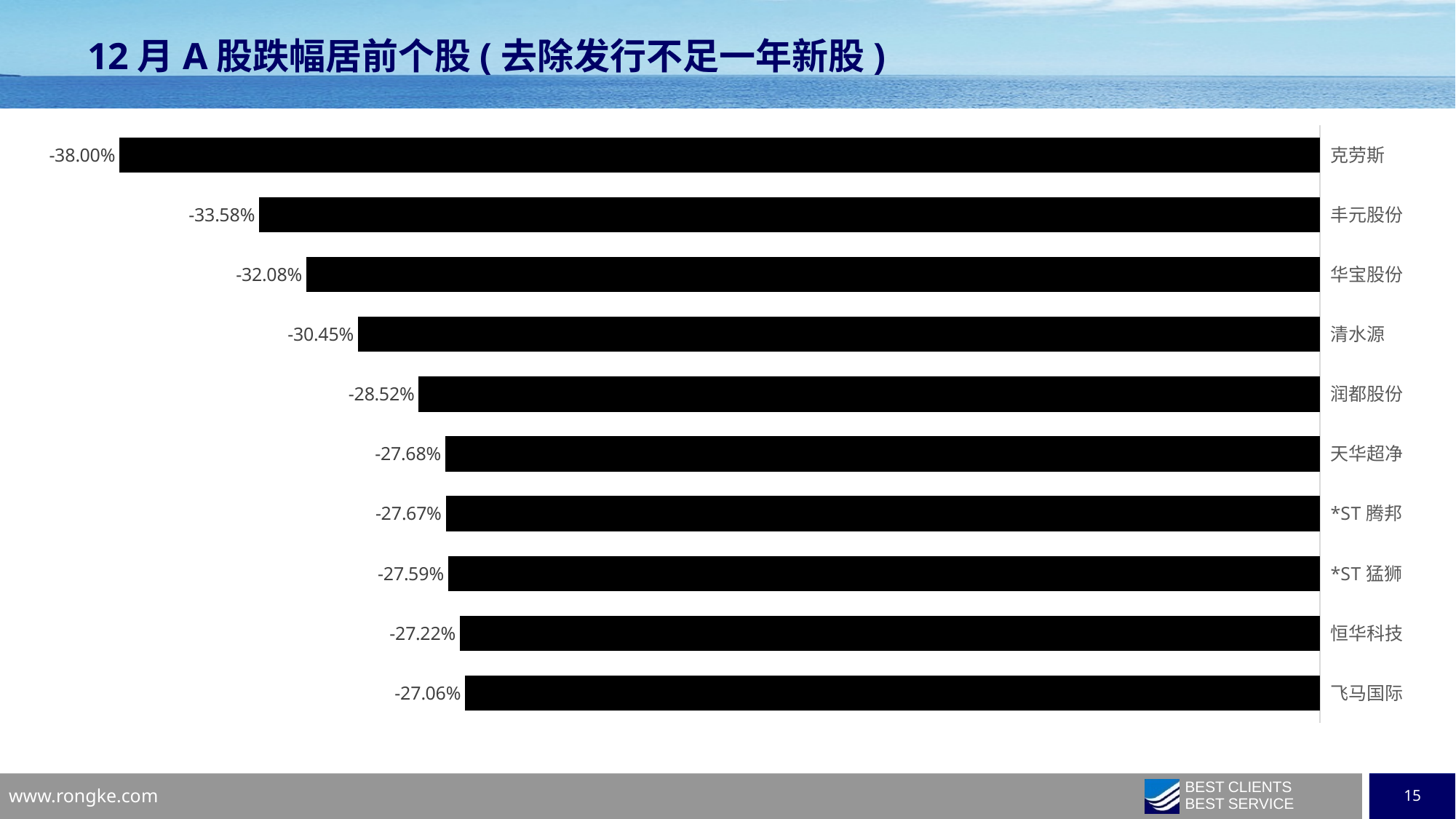
What is the value shown for 恒华科技? -27.22% What is the difference in percentage points between the values for 华宝股份 and 清水源? 1.63 percentage points Which stock fell more in December, 丰元股份 or 润都股份? 丰元股份 What is the value shown for 清水源? -30.45% What is the value shown for *ST 猛狮? -27.59% Which stock has the largest decline (the most negative value) on the chart? 克劳斯 What is the title of the chart on the slide? 12 月 A 股跌幅居前个股（去除发行不足一年新股） What is the difference in percentage points between the values for 克劳斯 and 丰元股份? 4.42 percentage points Which stock has the smallest decline (the least negative value) on the chart? 飞马国际 What kind of chart is shown on the slide? Bar chart How many stocks are shown on the chart? 10 What is the value shown for 克劳斯? -38.00%